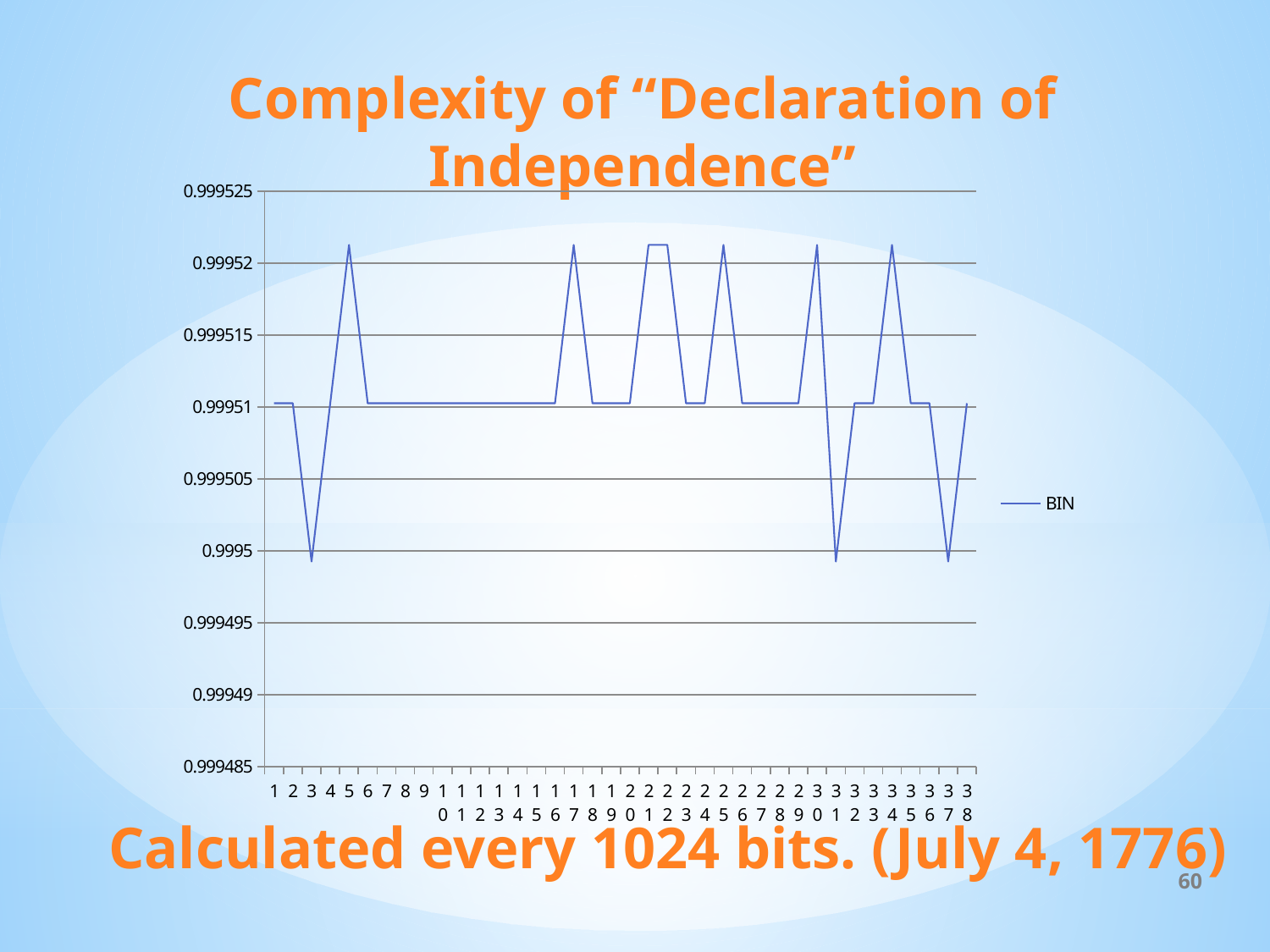
How many points are plotted along the x axis? 38 How many series does the legend list? 1 What is the title of the chart? Complexity of "Declaration of Independence" Is the value for point 31 greater or less than 0.999505? less Which has the larger value, point 3 or point 5? point 5 Is the value for point 3 greater or less than 0.999505? less Is the value for point 16 greater or less than 0.999515? less What is the name of the series shown in the legend? BIN Which has the larger value, point 31 or point 16? point 16 What kind of chart is shown on the slide? line chart